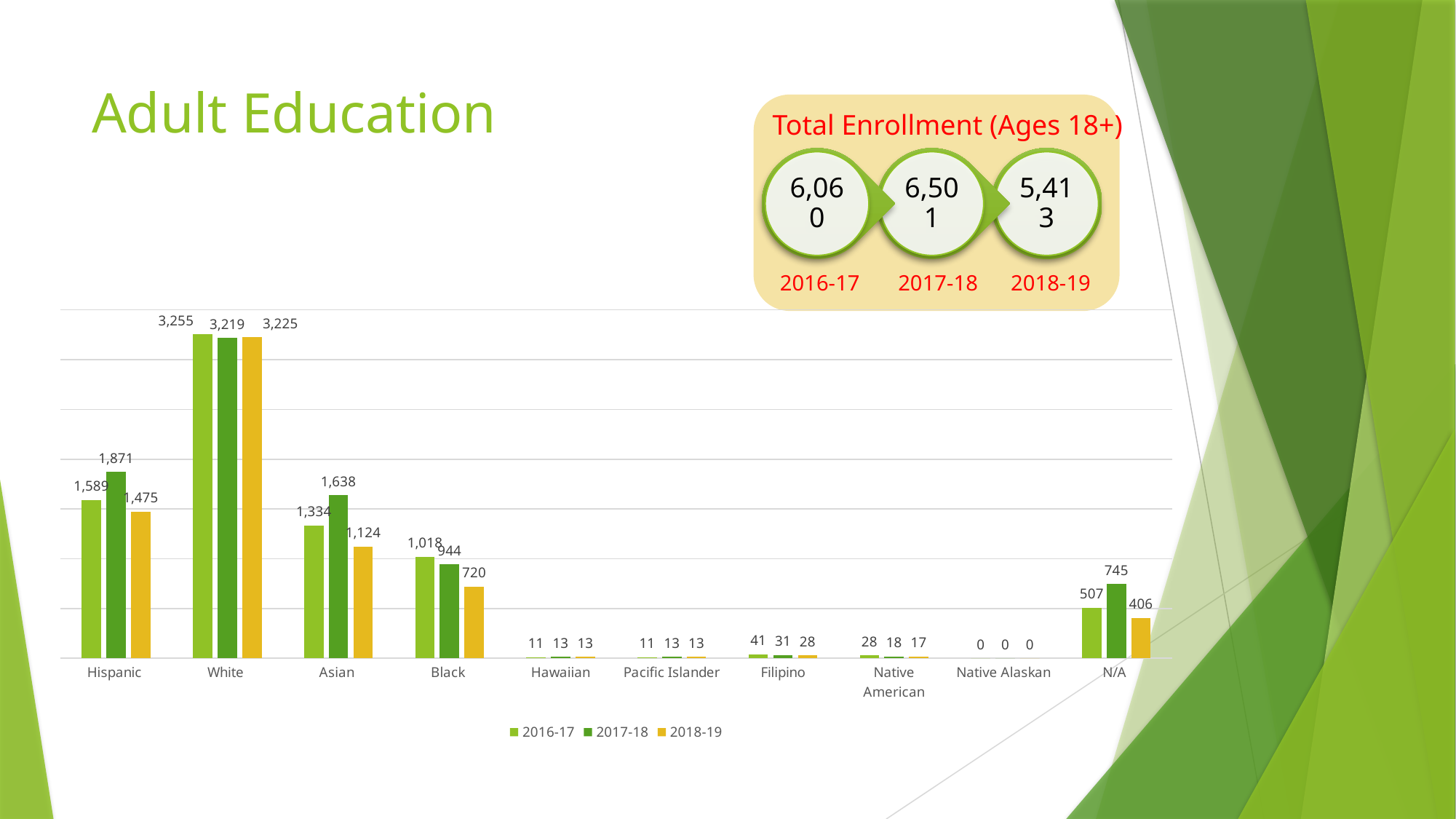
What is the value for N/A in 2017-18? 745 Which is larger for Asian: the 2016-17 value or the 2017-18 value? 2017-18 Which category has the highest value in 2018-19? White How many series does the legend list? 3 What kind of chart is shown on the slide? bar chart Which category has the lowest value in 2016-17? Native Alaskan How many categories are shown on the x axis? 10 What is the value for White in 2016-17? 3,255 Do the values for Filipino rise or fall from 2016-17 to 2018-19? fall What is the value for Hispanic in 2017-18? 1,871 What is the difference between the 2017-18 and 2018-19 values for Black? 224 What is the value for Asian in 2018-19? 1,124